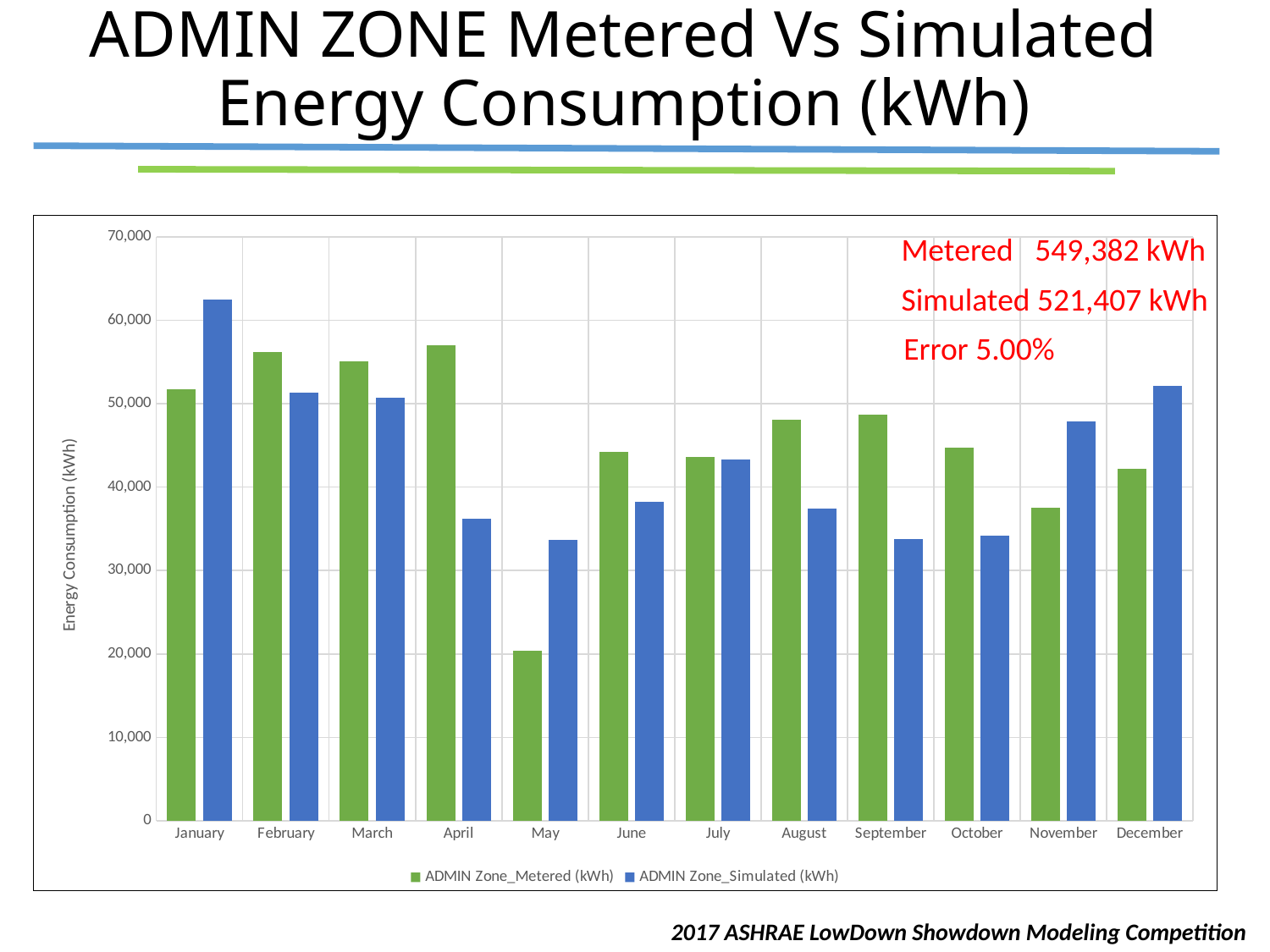
How many months are shown along the x axis? 12 Is the ADMIN Zone_Metered (kWh) value for May greater or less than 30,000? less How many series does the legend list? 2 What is the total Simulated energy consumption printed on the chart? 521,407 kWh What kind of chart is shown on the slide? Bar chart Which month has the lowest ADMIN Zone_Metered (kWh) value? May Which month has the highest ADMIN Zone_Simulated (kWh) value? January What Error percentage is printed on the chart? 5.00% In April, which is larger: the Metered value or the Simulated value? Metered Is the ADMIN Zone_Simulated (kWh) value for January greater or less than 60,000? greater What is the difference between the printed Metered total and the printed Simulated total? 27,975 kWh What is the total Metered energy consumption printed on the chart? 549,382 kWh